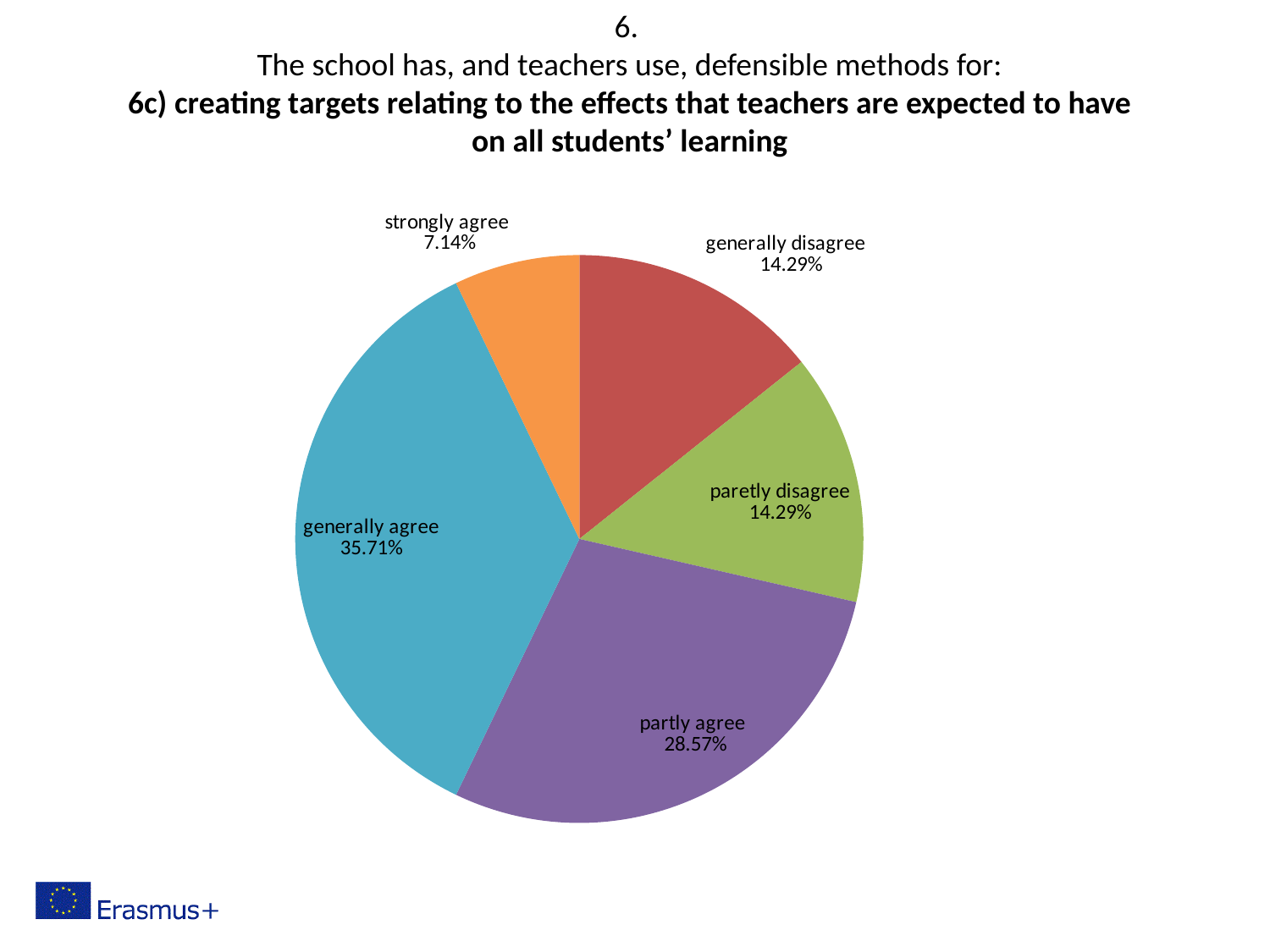
What colour is the "generally agree" slice? blue What is the combined share of "generally disagree" and "paretly disagree"? 28.58% What share of the pie is labelled "strongly agree"? 7.14% Which category has the largest slice of the pie? generally agree What is the difference in percentage points between "generally agree" and "partly agree"? 7.14 How many slices does the pie chart have? 5 What share of the pie is labelled "generally disagree"? 14.29% Which is larger, the "partly agree" slice or the "paretly disagree" slice? partly agree What share of the pie is labelled "generally agree"? 35.71% What share of the pie is labelled "partly agree"? 28.57% Which category has the smallest slice of the pie? strongly agree What kind of chart is shown on the slide? pie chart